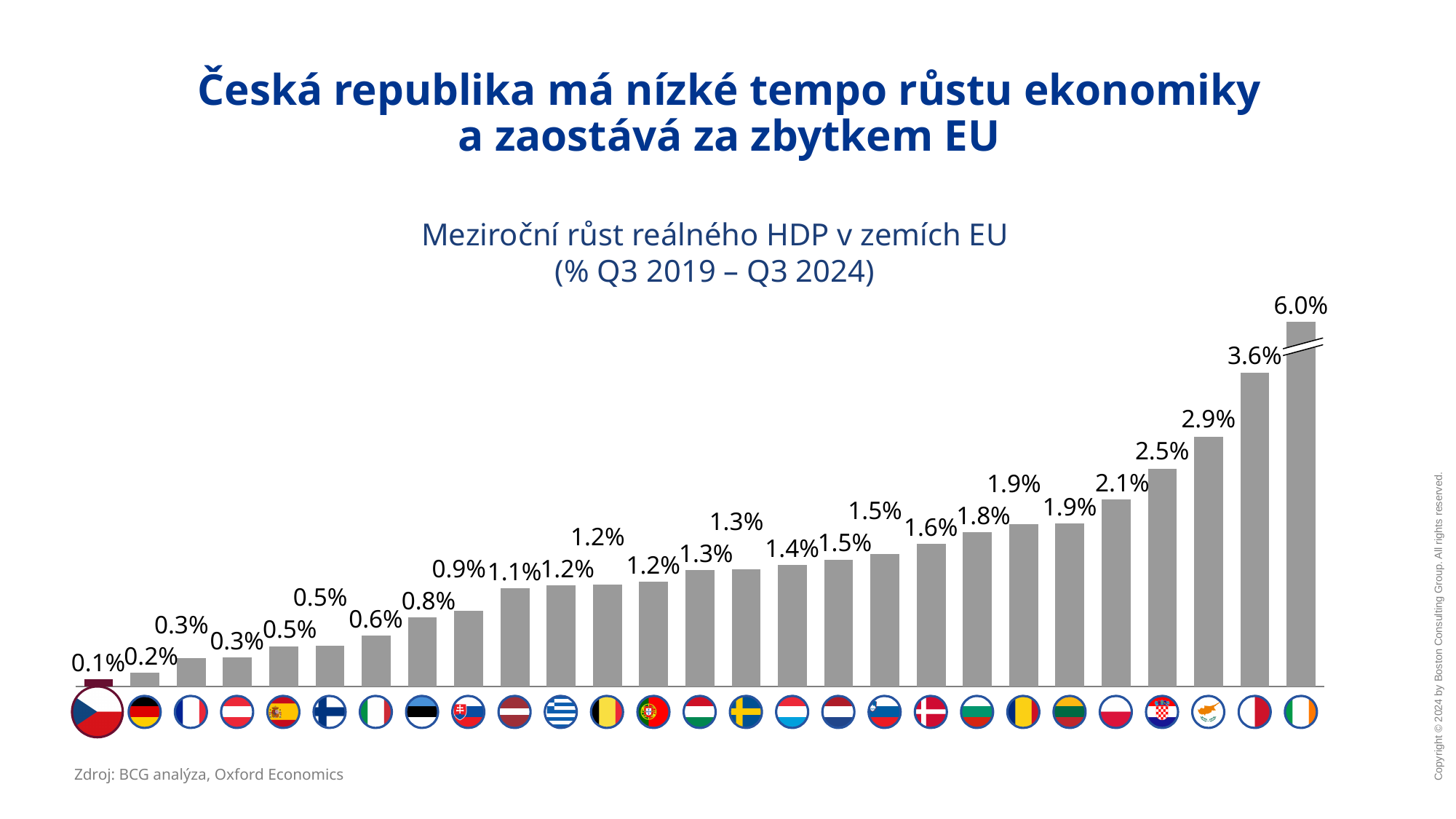
What is the value of the highlighted (dark red) first bar, representing the Czech Republic? 0.1% What source is cited for the chart? BCG analýza, Oxford Economics Do the bar values rise or fall from left to right across the chart? rise How many bars (countries) are shown in the chart? 27 What kind of chart is shown on the slide? bar chart What is the title of the chart? Meziroční růst reálného HDP v zemích EU (% Q3 2019 – Q3 2024) What is the value of the second-tallest bar in the chart? 3.6% Which is larger: the value of the second bar from the left (0.2%) or the value of the third bar from the right (2.9%)? 2.9% What is the value of the shortest bar in the chart? 0.1% What is the difference between the tallest bar (6.0%) and the second-tallest bar (3.6%)? 2.4% What is the value of the tallest bar, at the far right of the chart? 6.0% What is the difference between the highest value (6.0%) and the lowest value (0.1%) in the chart? 5.9%